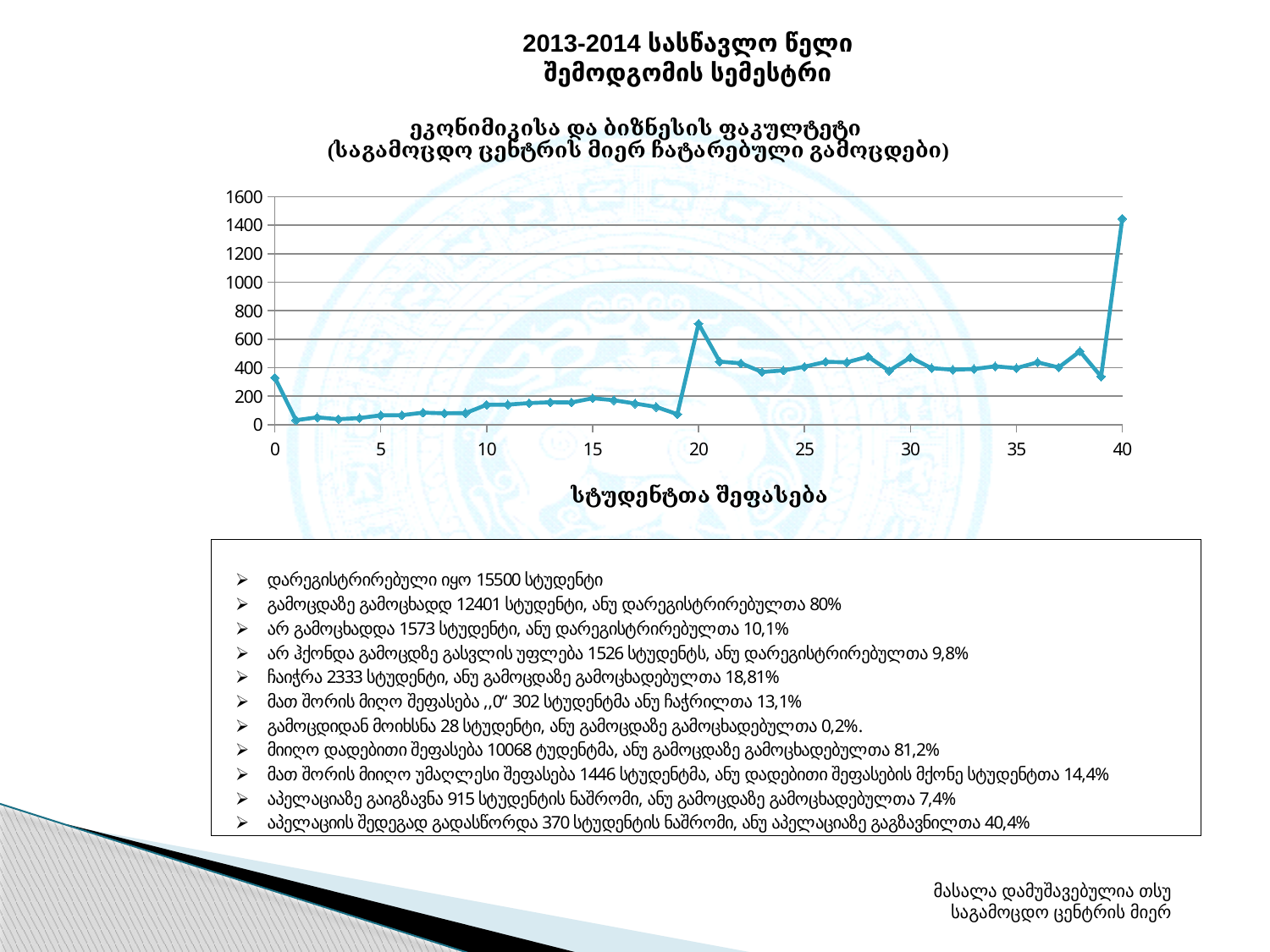
Is the value at x = 38 greater or less than 400? greater Does the line rise or fall between x = 0 and x = 1? fall Is the value at x = 20 greater or less than 600? greater Is the value at x = 10 greater or less than 200? less Which is larger, the value at x = 20 or the value at x = 25? x = 20 At which x-axis value does the line reach its highest point? 40 What is the title shown below the x axis of the chart? სტუდენტთა შეფასება What kind of chart is shown on the slide? line chart Which is larger, the value at x = 15 or the value at x = 5? x = 15